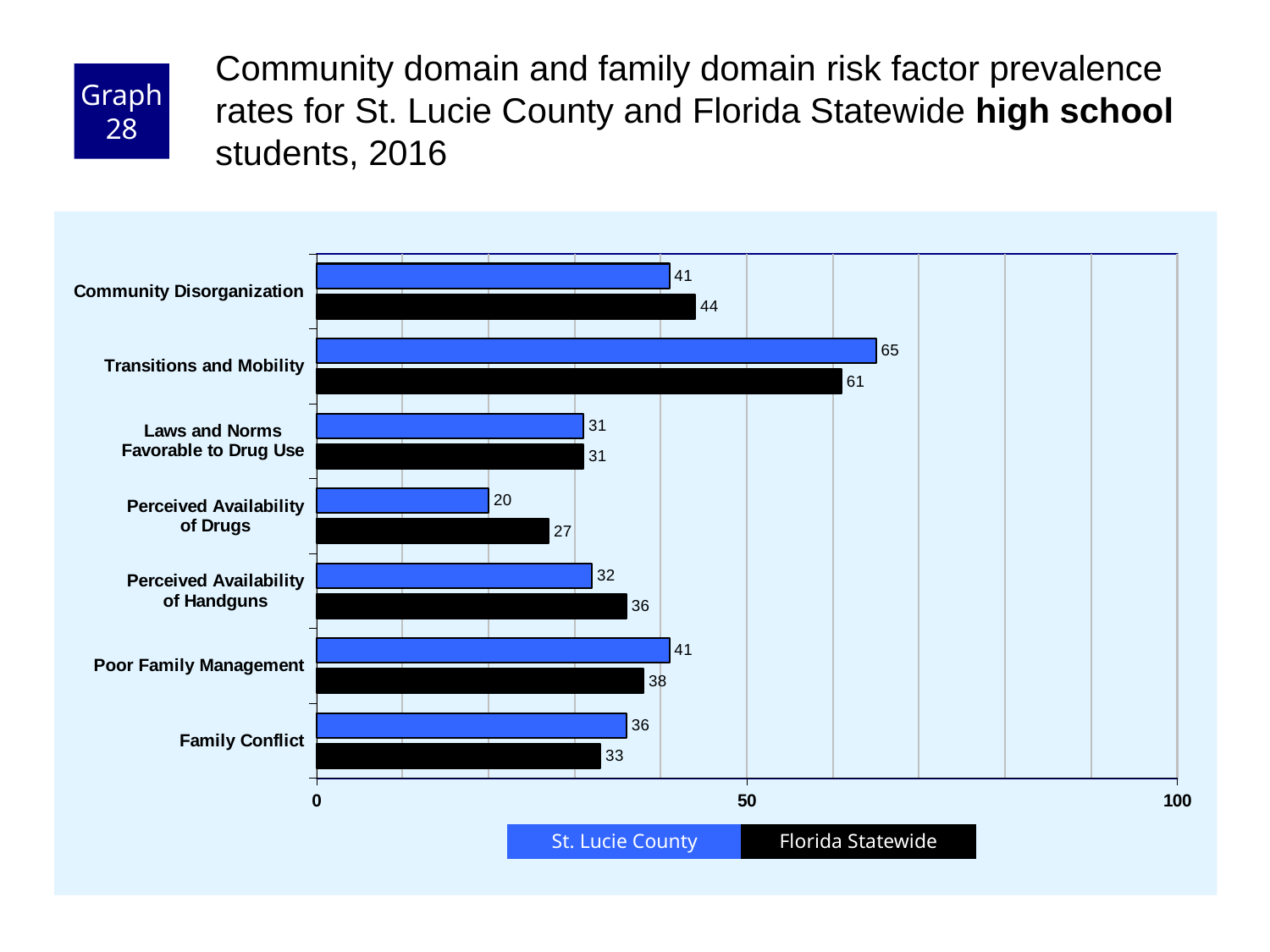
Which risk factor has the lowest Florida Statewide value? Perceived Availability of Drugs Which risk factor has the highest St. Lucie County value? Transitions and Mobility What is the Florida Statewide value for Perceived Availability of Drugs? 27 What is the St. Lucie County value for Family Conflict? 36 What is the St. Lucie County value for Transitions and Mobility? 65 How many series does the legend list? 2 How many risk factor categories are shown on the chart? 7 What kind of chart is shown on the slide? bar chart What is the difference between the St. Lucie County and Florida Statewide values for Perceived Availability of Drugs? 7 For Poor Family Management, which is larger: the St. Lucie County value or the Florida Statewide value? St. Lucie County Is the Florida Statewide value for Transitions and Mobility greater or less than 50? greater Which colour represents Florida Statewide in the chart? black